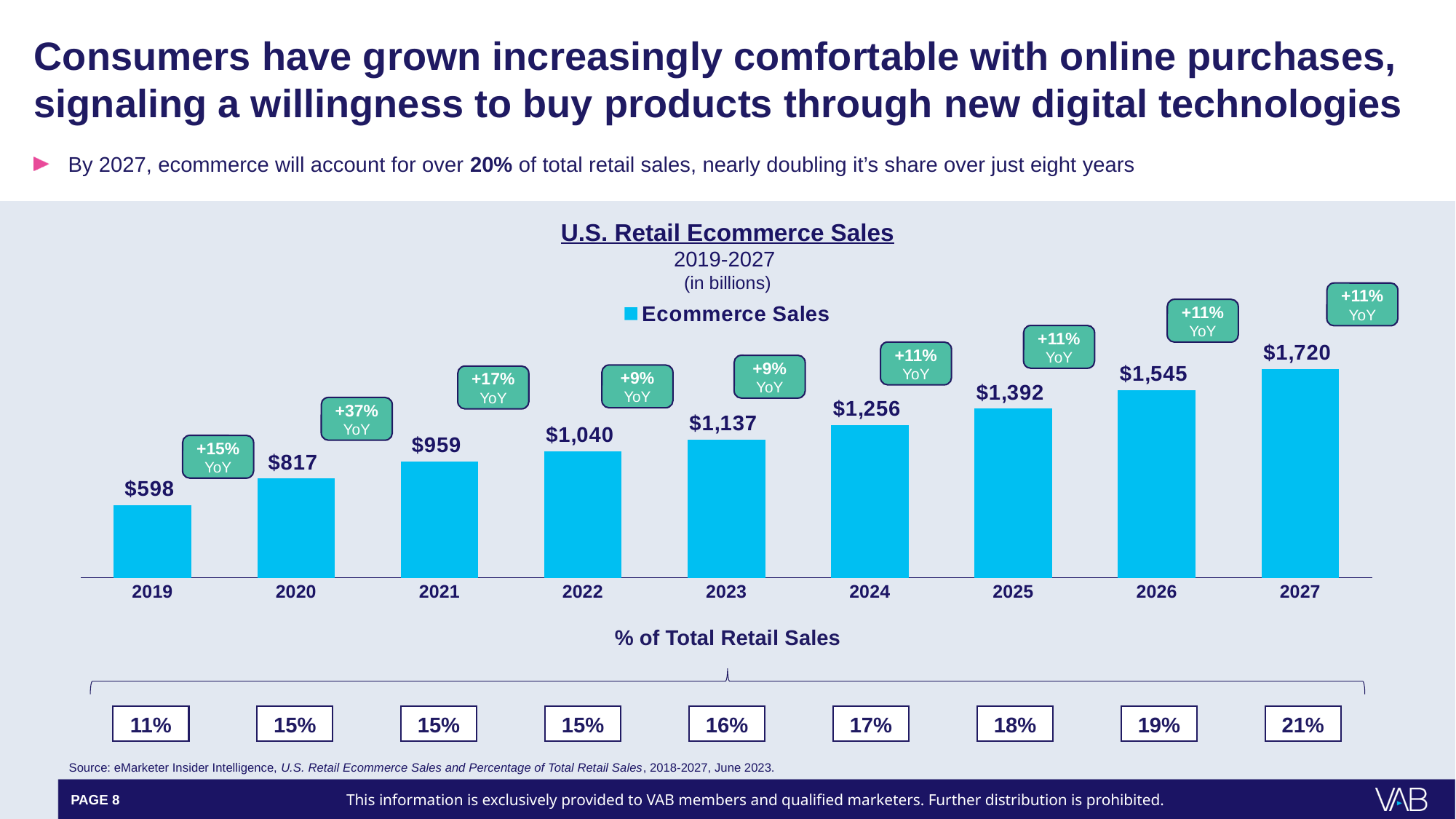
Which year has higher ecommerce sales, 2022 or 2023? 2023 Which year has the lowest ecommerce sales? 2019 What is the ecommerce sales value for 2024? $1,256 Which year has the highest ecommerce sales? 2027 What is the ecommerce sales value for 2019? $598 What kind of chart is shown on the slide? Bar chart What is the difference in ecommerce sales between 2020 and 2019? $219 How many series does the legend list? 1 How many years are shown on the x axis of the chart? 9 What is the difference in ecommerce sales between 2027 and 2026? $175 Do ecommerce sales rise or fall from 2019 to 2027? Rise What is the ecommerce sales value for 2027? $1,720